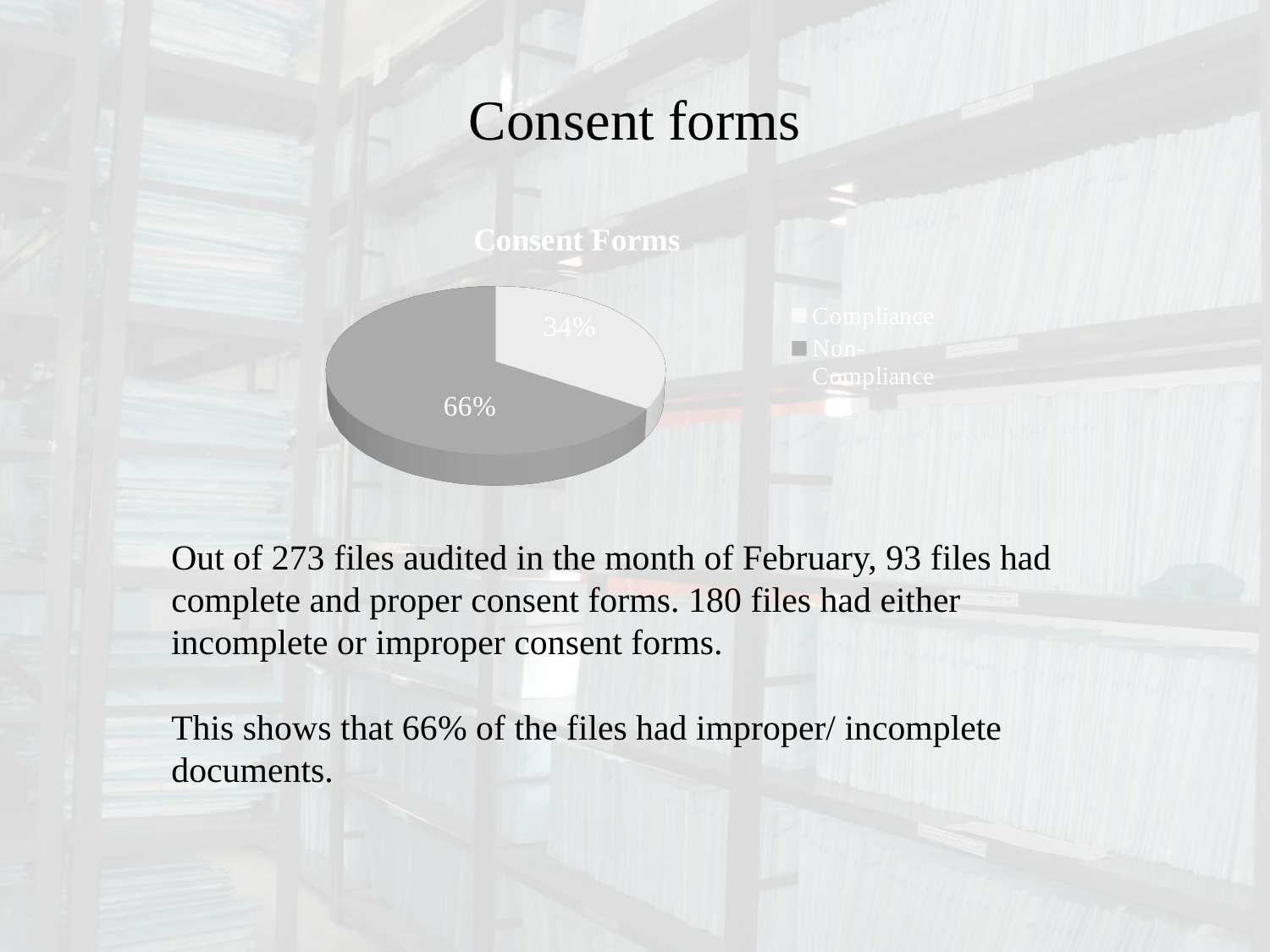
Is the share for Compliance greater or less than 50%? less Which is larger, the Compliance slice or the Non-Compliance slice? Non-Compliance What share of the pie does the Non-Compliance slice represent? 66% What is the difference in percentage points between the Non-Compliance and Compliance slices? 32 Which slice is the smallest in the pie chart? Compliance How many slices does the pie chart have? 2 What kind of chart is shown on the slide? pie chart Which slice is the largest in the pie chart? Non-Compliance What share of the pie does the Compliance slice represent? 34% Which legend entry is shown in the darker grey colour? Non-Compliance What is the title of the chart? Consent Forms How many entries does the legend list? 2